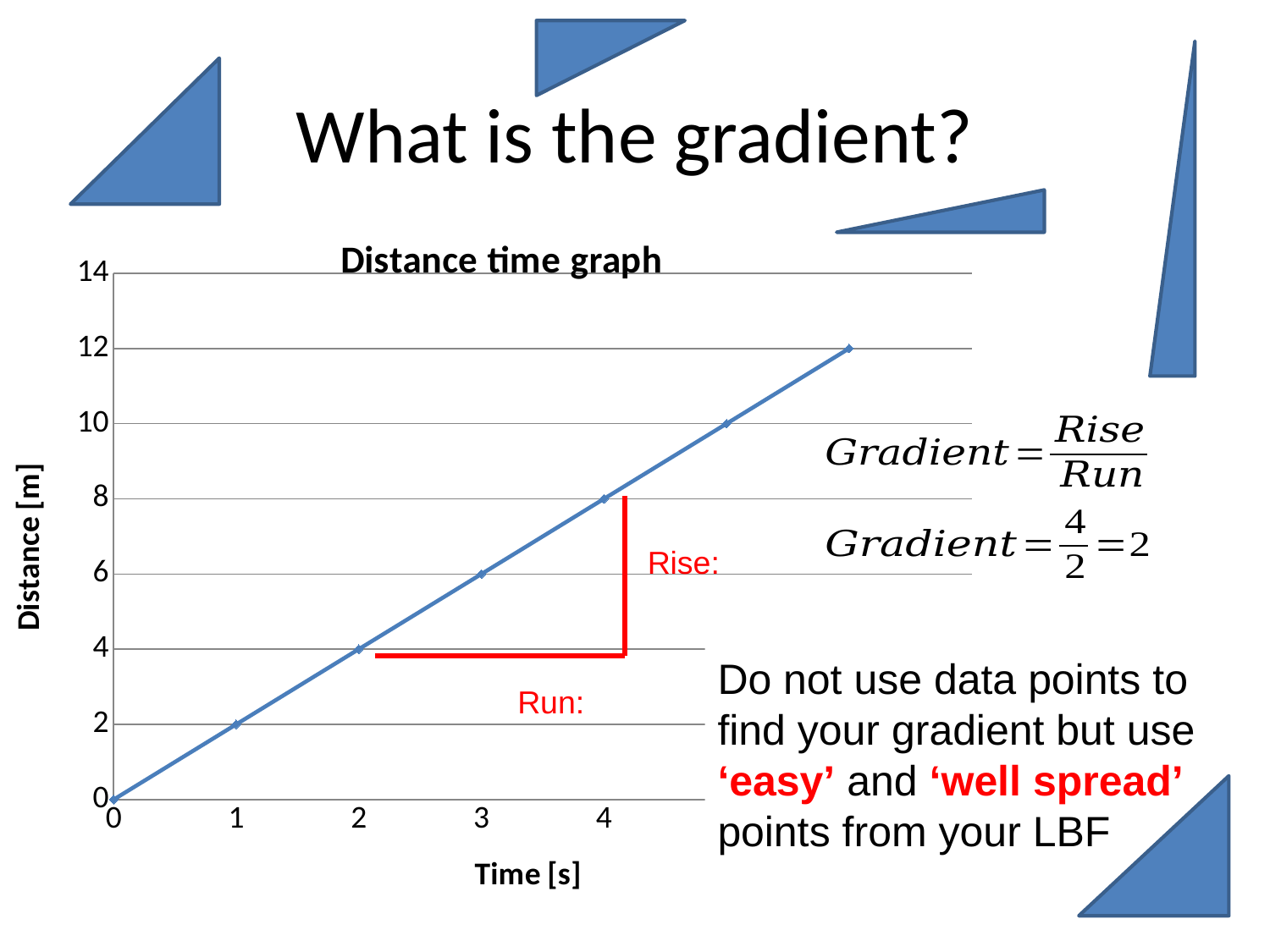
What is the difference between the distance at 4 s and the distance at 2 s? 4 What is the title of the chart? Distance time graph Is the distance at time 3 s greater or less than 10? less What is the distance at time 4 s? 8 What is the label of the vertical axis of the chart? Distance [m] What is the distance at time 0 s? 0 Do the distance values rise or fall as time increases along the x axis? rise How many data points are plotted on the line? 7 What is the distance at time 1 s? 2 What is the distance at time 2 s? 4 What is the distance at time 3 s? 6 What kind of chart is shown on the slide? line chart